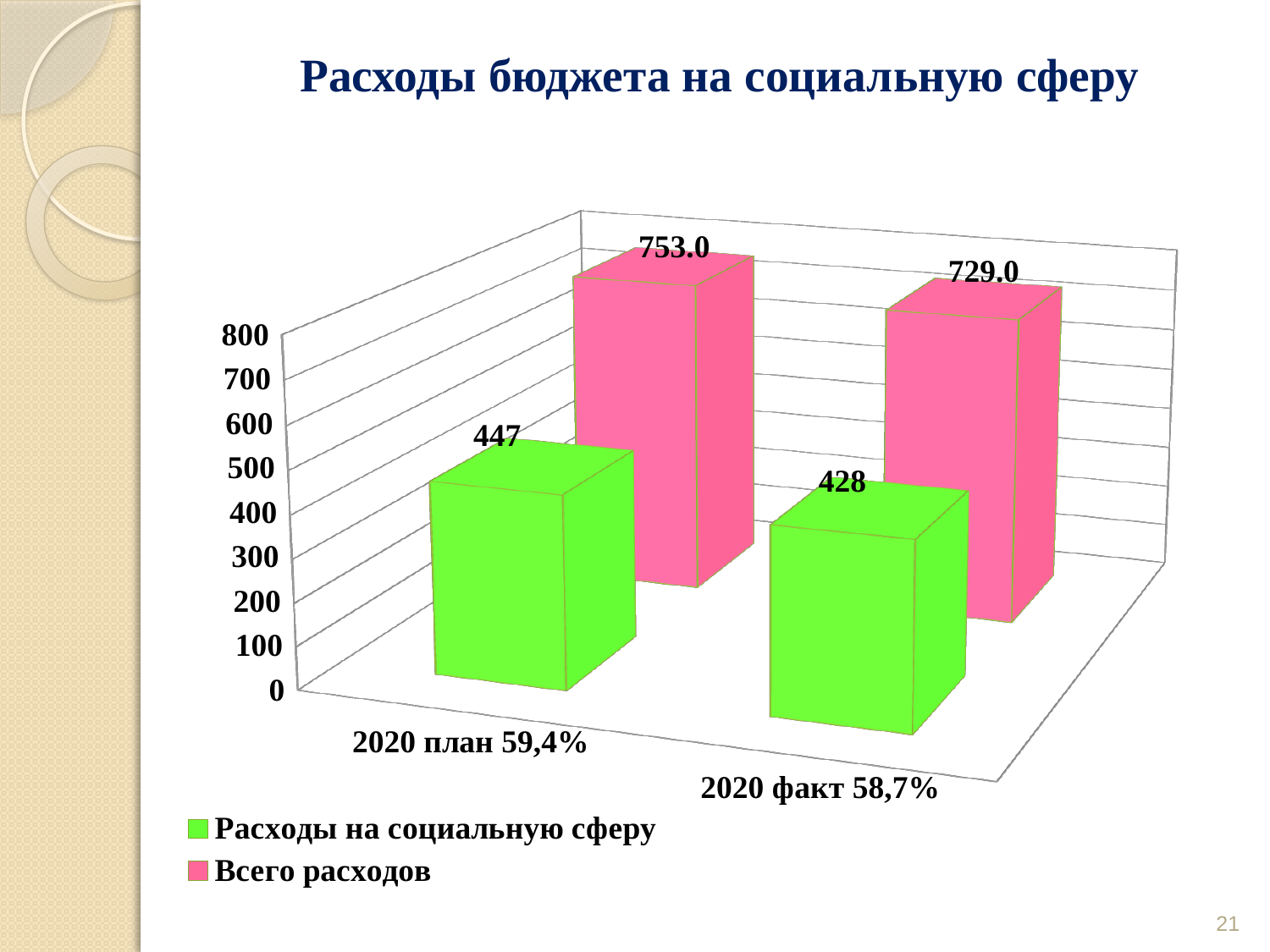
Which category has the lower value for 'Расходы на социальную сферу'? 2020 факт 58,7% What is the value of 'Расходы на социальную сферу' for '2020 факт 58,7%'? 428 What type of chart is shown on the slide? bar chart Which is larger: 'Расходы на социальную сферу' for '2020 план 59,4%' or 'Всего расходов' for '2020 факт 58,7%'? Всего расходов for 2020 факт 58,7% How many categories are shown on the x axis? 2 What is the difference between 'Всего расходов' for '2020 план 59,4%' and '2020 факт 58,7%'? 24.0 What is the difference between 'Расходы на социальную сферу' for '2020 план 59,4%' and '2020 факт 58,7%'? 19 What is the value of 'Всего расходов' for '2020 факт 58,7%'? 729.0 Which category has the higher value for 'Всего расходов'? 2020 план 59,4% What is the value of 'Расходы на социальную сферу' for '2020 план 59,4%'? 447 How many series does the legend list? 2 What is the value of 'Всего расходов' for '2020 план 59,4%'? 753.0